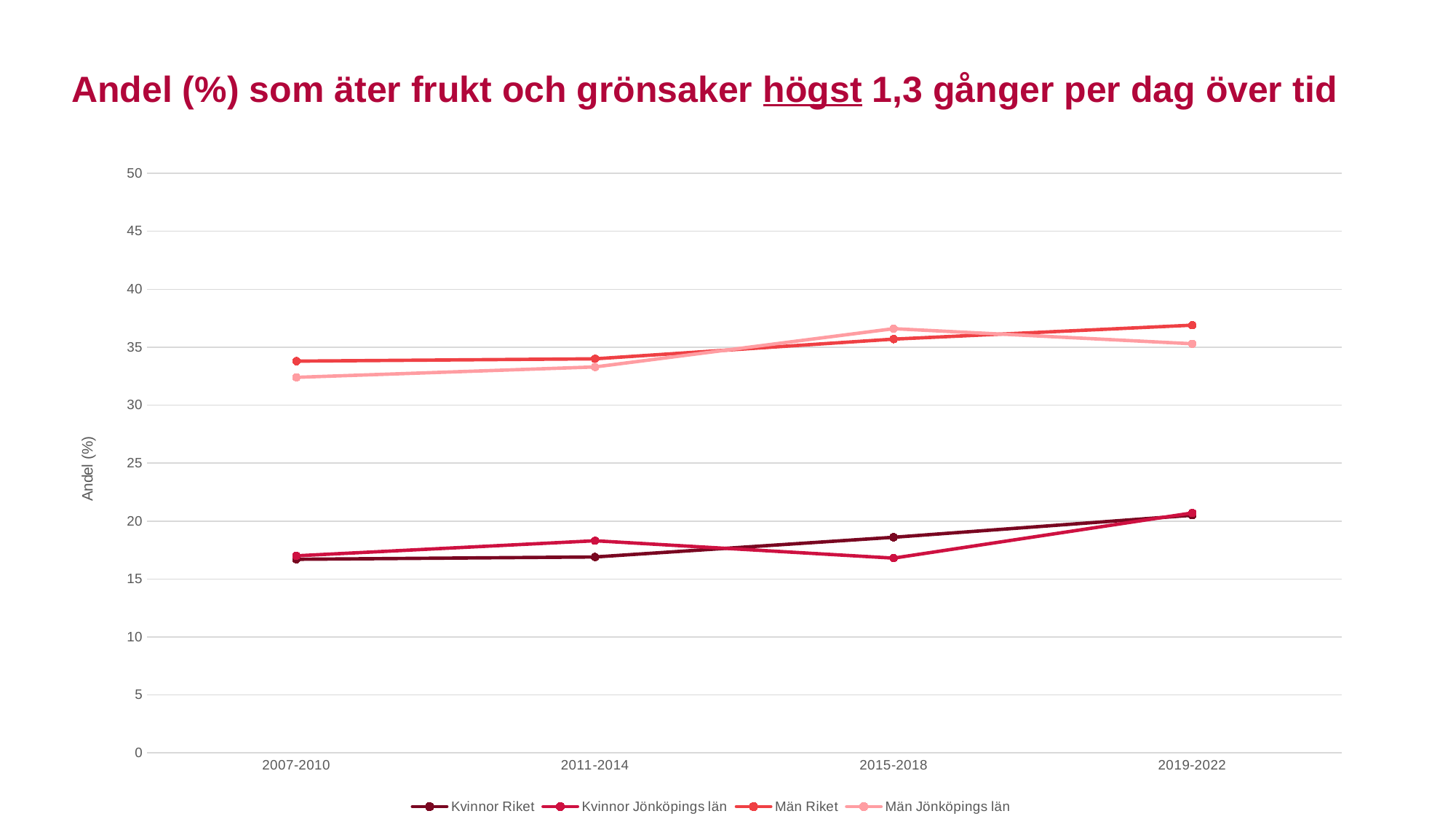
Does the value for Män Riket rise or fall from 2007-2010 to 2019-2022? rise In which period is the value for Män Jönköpings län lowest? 2007-2010 Is the value for Män Riket in 2019-2022 greater or less than 35? greater How many series does the legend list? 4 What is the label on the y axis? Andel (%) In 2019-2022, which is larger: Män Riket or Kvinnor Riket? Män Riket In 2007-2010, which is larger: Män Riket or Män Jönköpings län? Män Riket Is the value for Kvinnor Riket in 2007-2010 greater or less than 20? less What kind of chart is shown on the slide? line chart Is the value for Män Jönköpings län in 2007-2010 greater or less than 30? greater How many time periods are shown on the x axis? 4 Does the value for Kvinnor Riket rise or fall from 2007-2010 to 2019-2022? rise